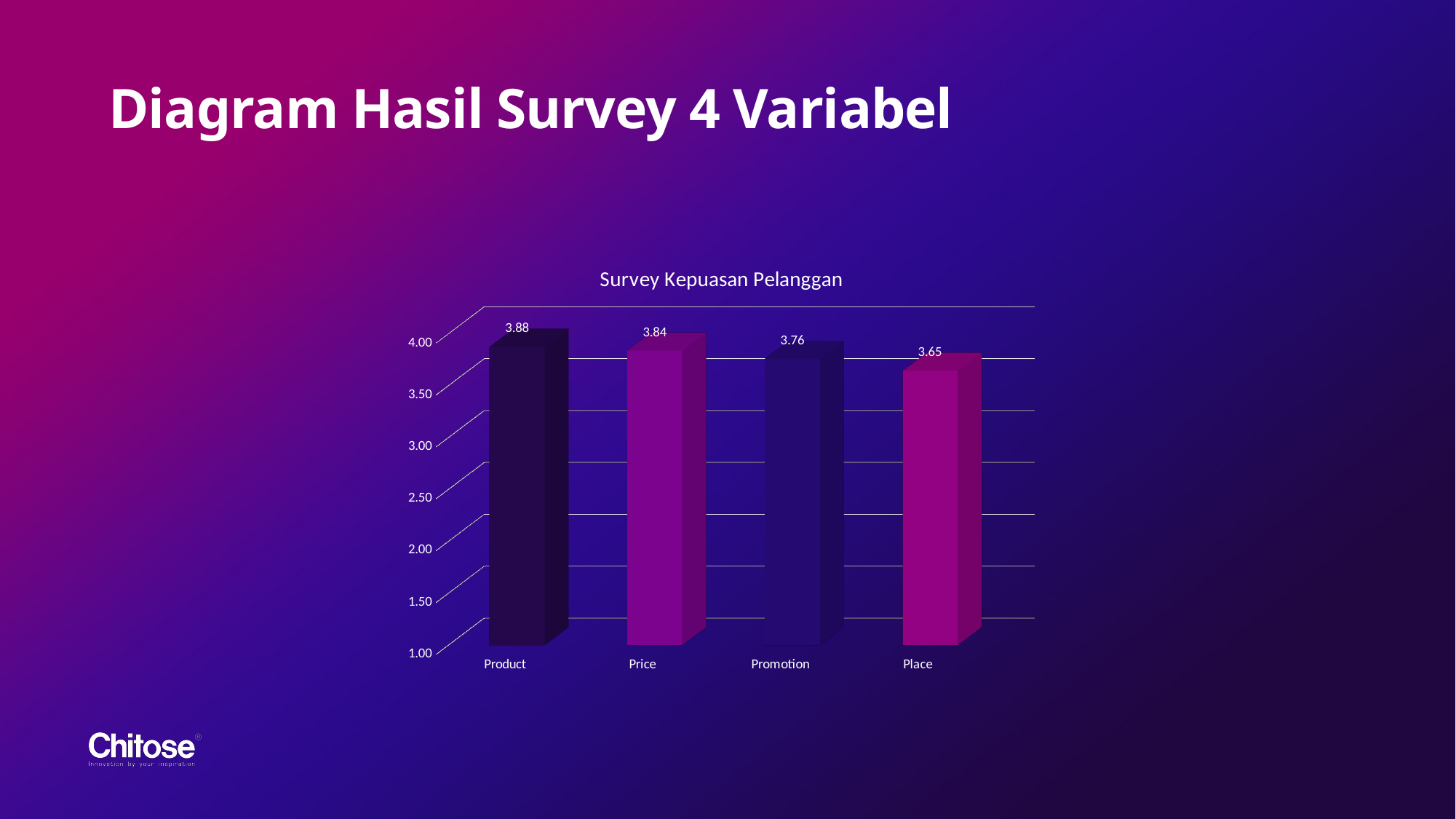
Is the value for Place greater or less than 3.50? greater What kind of chart is shown? Bar chart Which category has the highest value? Product What is the value for Promotion? 3.76 Which category has the lowest value? Place How many categories are shown in the chart? 4 Which is larger, the value for Promotion or the value for Place? Promotion What is the title of the chart? Survey Kepuasan Pelanggan What is the value for Place? 3.65 What is the difference between the values for Product and Place? 0.23 What is the value for Product? 3.88 What is the value for Price? 3.84